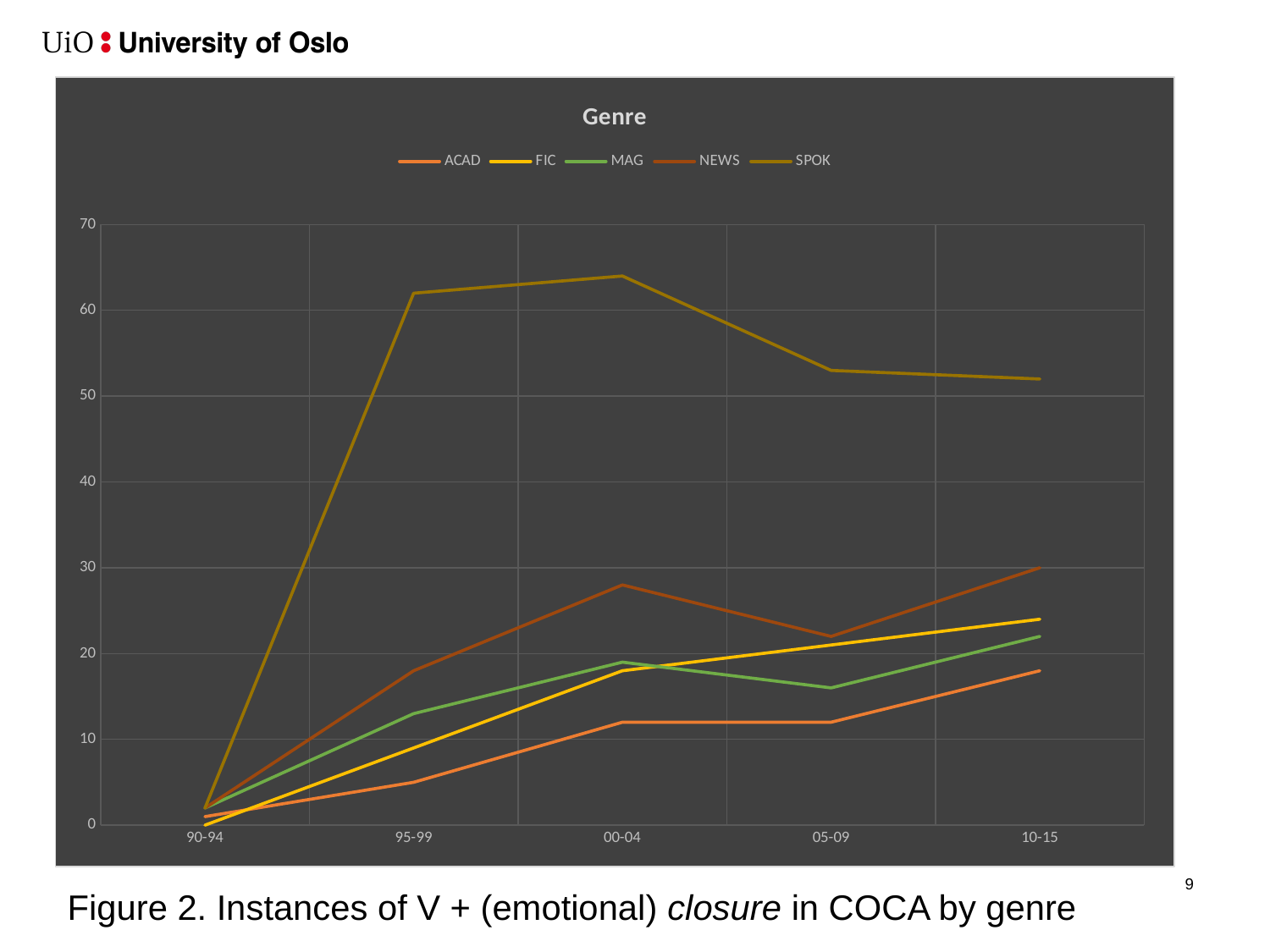
Is the value for NEWS in 00-04 greater or less than 20? greater Which genre has the highest value in the 00-04 period? SPOK Is the value for SPOK in 95-99 greater or less than 50? greater In the 05-09 period, which is larger, the value for NEWS or the value for MAG? NEWS How many time periods are shown on the x axis? 5 How many series does the legend list? 5 Is the value for ACAD in 95-99 greater or less than 10? less Which genre has the lowest value in the 10-15 period? ACAD Which genre has the lowest value in the 95-99 period? ACAD What kind of chart is shown on the slide? line chart What is the title of the chart? Genre Does the SPOK line rise or fall from 00-04 to 10-15? fall